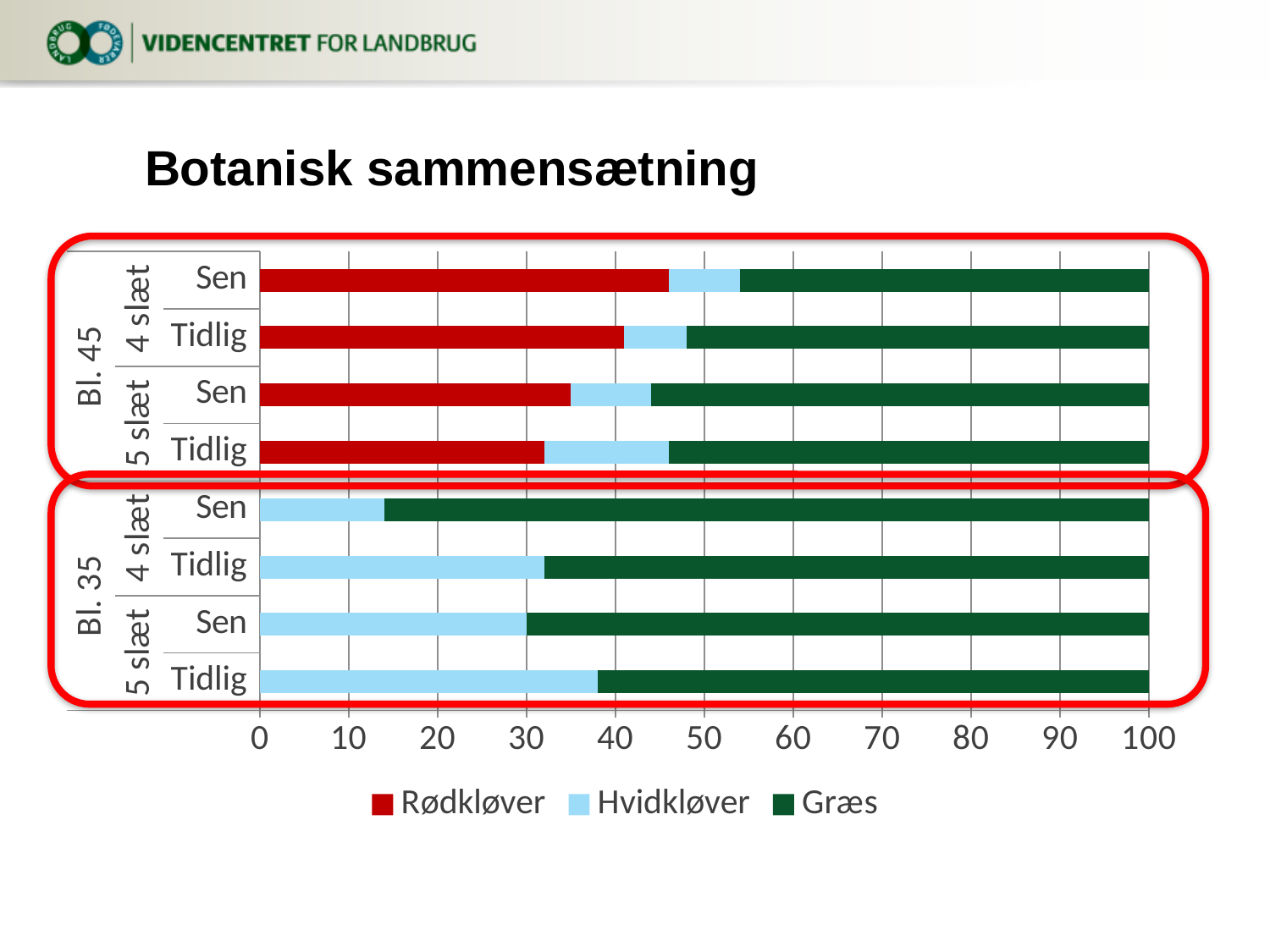
Which has the larger Hvidkløver segment: Bl. 35, 4 slæt, Sen or Bl. 35, 5 slæt, Tidlig? Bl. 35, 5 slæt, Tidlig What is the title of the chart? Botanisk sammensætning Is the Hvidkløver value for Bl. 35, 4 slæt, Sen greater or less than 20? less Which bar has the largest Rødkløver segment? Bl. 45, 4 slæt, Sen Is the Hvidkløver value for Bl. 35, 5 slæt, Tidlig greater or less than 30? greater What is the total of the stacked bar for Bl. 45, 4 slæt, Sen? 100 Is the Rødkløver value for Bl. 45, 5 slæt, Tidlig greater or less than 40? less How many bars are plotted in the chart? 8 Which series is shown in red in the legend? Rødkløver What kind of chart is shown on the slide? Stacked bar chart How many series does the legend list? 3